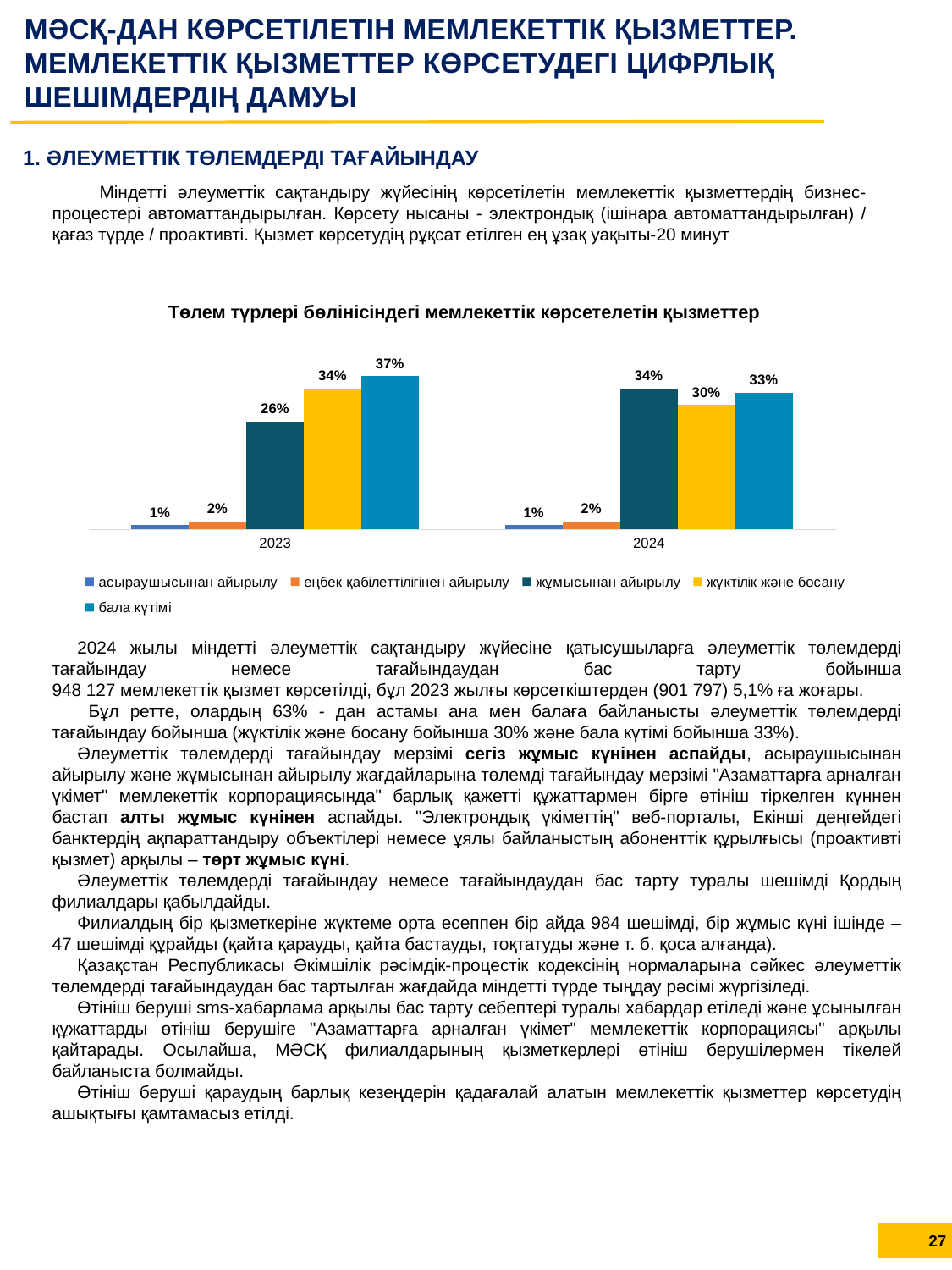
What type of chart is shown under the title "Төлем түрлері бөлінісіндегі мемлекеттік көрсетелетін қызметтер"? bar chart What is the value for "бала күтімі" in 2024? 33% Does the value for "бала күтімі" rise or fall from 2023 to 2024? fall Which is larger: the value for "жүктілік және босану" in 2023 or in 2024? 2023 What is the difference between the 2024 and 2023 values for "жұмысынан айырылу"? 8% What is the value for "жүктілік және босану" in 2024? 30% What is the value for "еңбек қабілеттілігінен айырылу" in 2023? 2% Which series has the lowest value in 2024? асыраушысынан айырылу How many series does the legend of the chart list? 5 What is the value for "жұмысынан айырылу" in 2023? 26% How many categories are shown on the x axis of the chart? 2 Which series has the highest value in 2023? бала күтімі